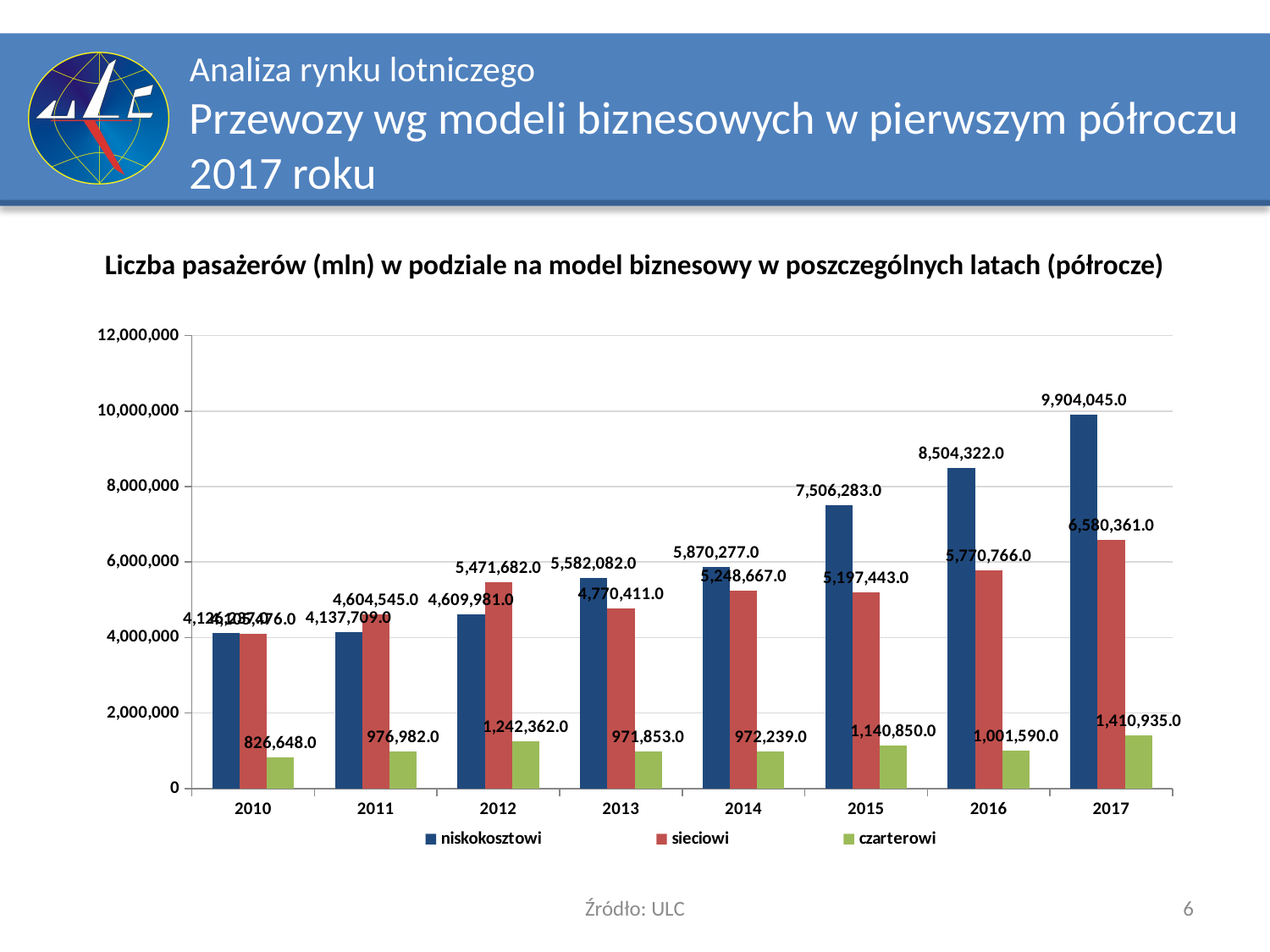
In 2012, which is larger: niskokosztowi or sieciowi? sieciowi What is the value for czarterowi in 2012? 1,242,362.0 Is the value for niskokosztowi in 2015 greater or less than 8,000,000? less What is the value for sieciowi in 2016? 5,770,766.0 How many series does the legend list? 3 In which year is the czarterowi value the lowest? 2010 What is the difference between the niskokosztowi and sieciowi values in 2017? 3,323,684.0 What is the value for niskokosztowi in 2017? 9,904,045.0 How many years are shown on the x axis? 8 What kind of chart is shown on the slide? bar chart Do the niskokosztowi values rise or fall from 2013 to 2017? rise In which year is the niskokosztowi value the highest? 2017